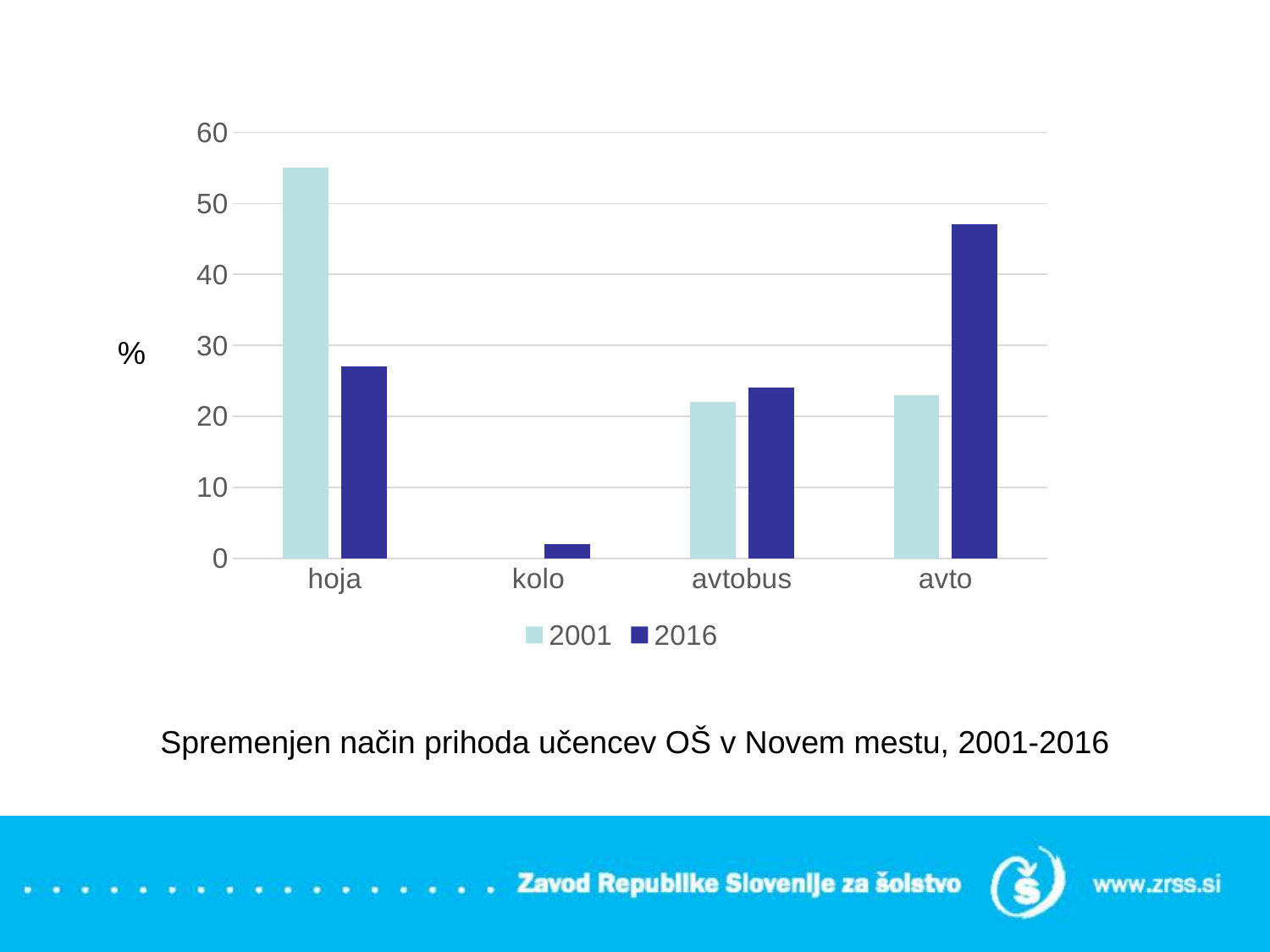
What label is shown on the vertical axis? % For avto, which year has the larger value, 2001 or 2016? 2016 Which category has the highest value for 2001? hoja Is the 2016 value for kolo greater or less than 10? less Is the 2001 value for hoja greater or less than 50? greater For hoja, which year has the larger value, 2001 or 2016? 2001 How many categories are shown on the x axis? 4 Is the 2016 value for avto greater or less than 40? greater Which category has the lowest value for 2016? kolo How many series does the legend list? 2 What kind of chart is shown on the slide? bar chart Which category has the highest value for 2016? avto